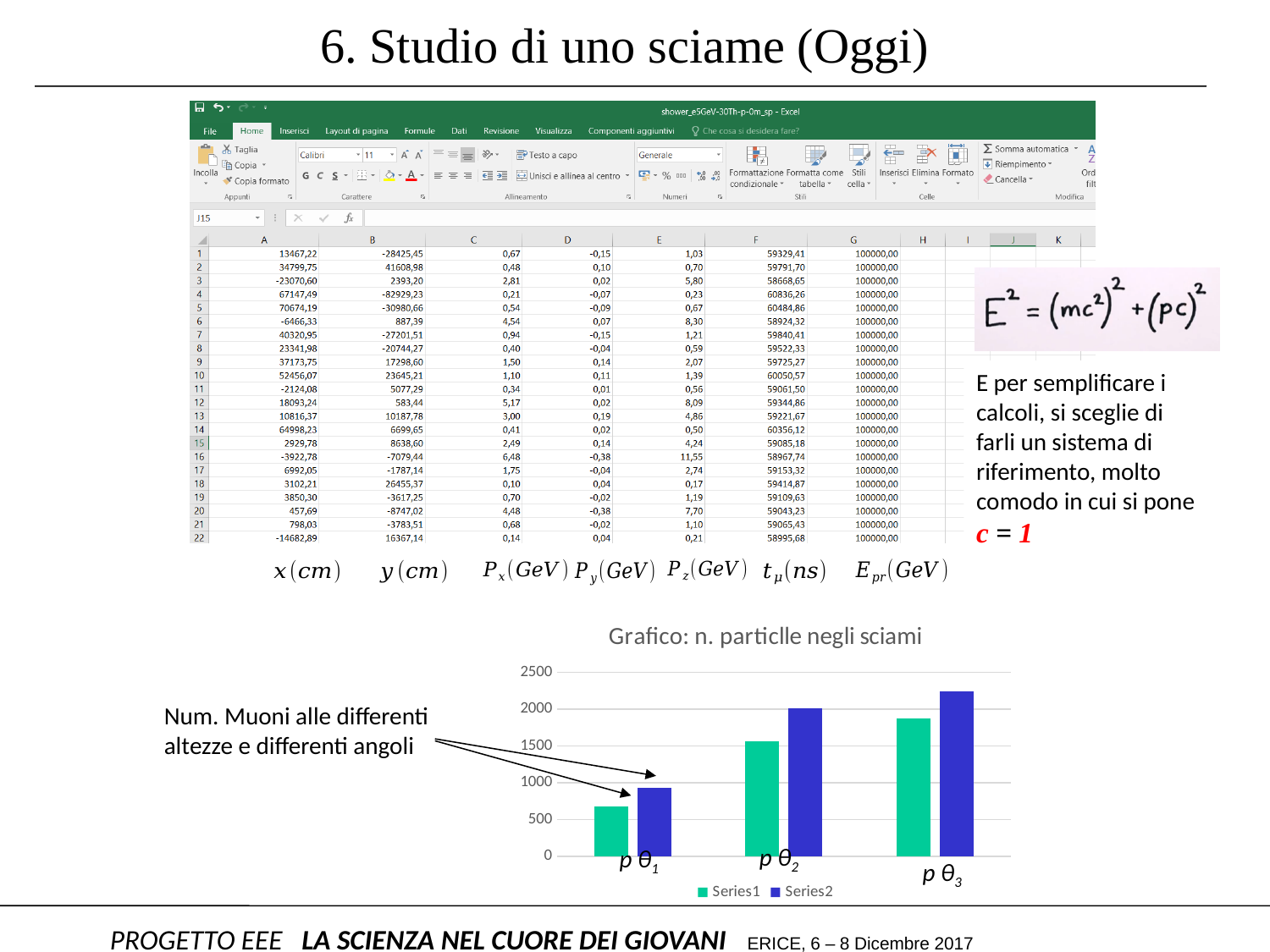
How many series does the chart's legend list? 2 Do the Series1 values rise or fall from p θ1 to p θ3? rise For category p θ1, which is larger: Series1 or Series2? Series2 Which category has the highest Series2 value in the chart? p θ3 How many categories are shown on the x axis of the chart? 3 Is the Series1 value for p θ1 greater or less than 1000? less Is the Series1 value for p θ3 greater or less than 1500? greater What is the title of the chart on the slide? Grafico: n. particlle negli sciami Is the Series2 value for p θ3 greater or less than 2000? greater What colour are the Series2 bars in the chart? blue What kind of chart is shown on the slide? bar chart Which category has the lowest Series1 value in the chart? p θ1